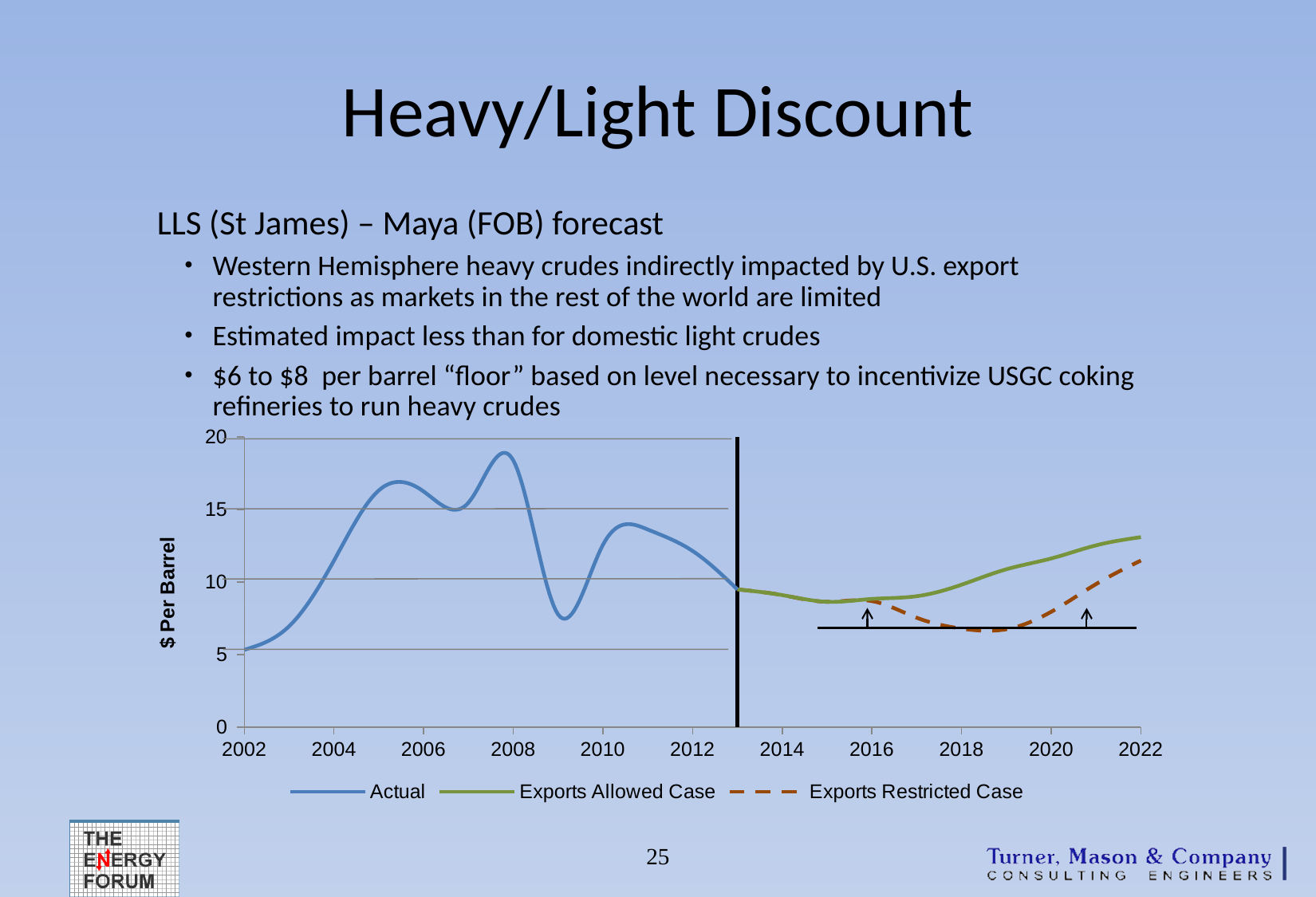
Which series in the legend is drawn with a dashed line? Exports Restricted Case Is the value of the Actual series in 2008 greater or less than 15? greater Does the Actual series rise or fall between 2010 and 2013? Fall In 2020, which series has the higher value: Exports Allowed Case or Exports Restricted Case? Exports Allowed Case What is the label on the vertical axis of the chart? $ Per Barrel Is the value of the Exports Allowed Case in 2022 greater or less than 10? greater Does the Exports Allowed Case rise or fall between 2016 and 2022? Rise What kind of chart is shown on the slide? Line chart Is the value of the Actual series in 2002 greater or less than 10? less How many series does the chart legend list? 3 In which year does the Actual series reach its highest value? 2008